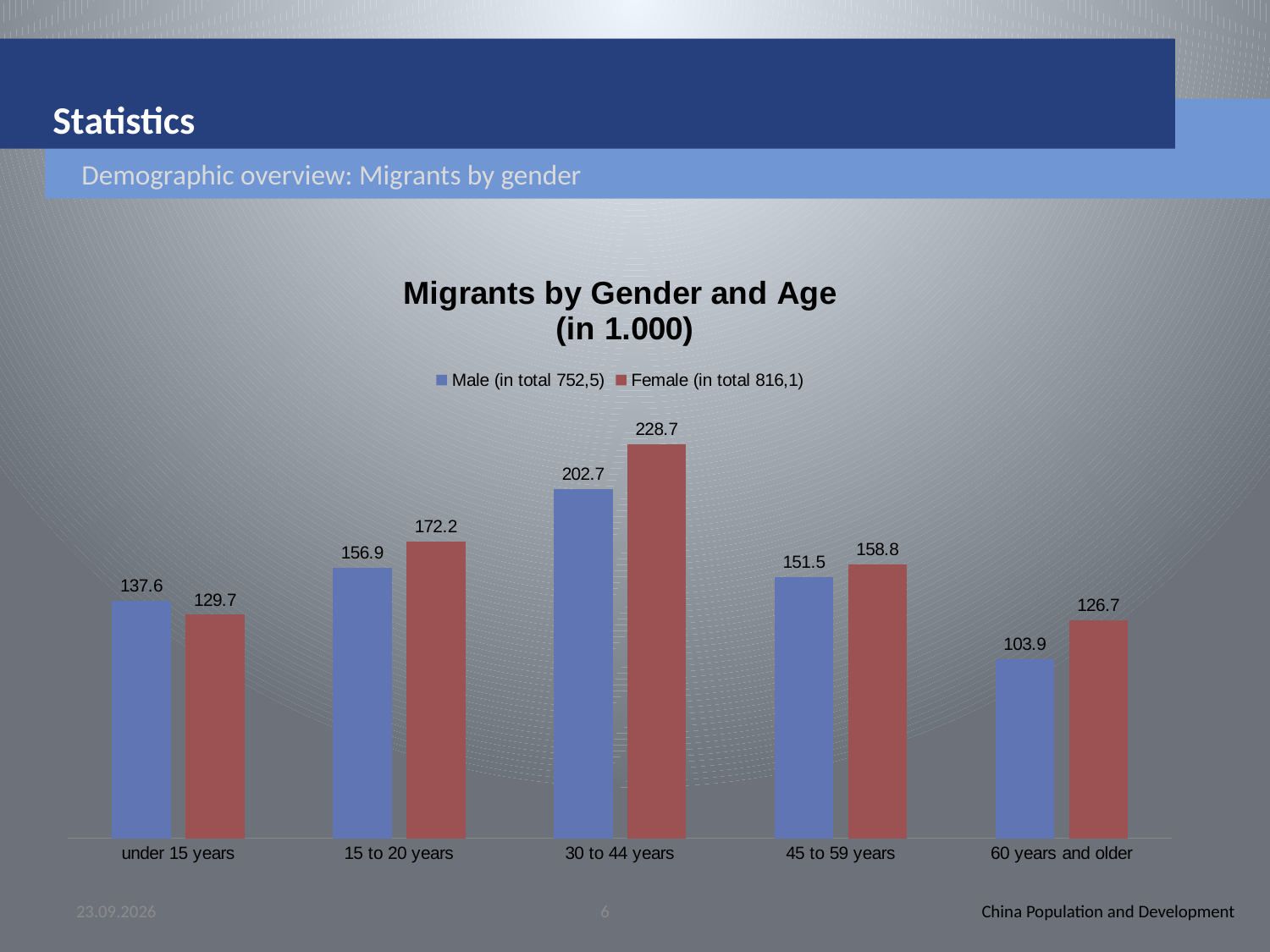
Which age group has the lowest Male value? 60 years and older What is the difference between the Female and Male values for 30 to 44 years? 26 Which age group has the highest Female value? 30 to 44 years What is the Female value for the 60 years and older age group? 126.7 For the under 15 years group, which is larger, the Male or the Female value? Male What kind of chart is shown on the slide? Bar chart What is the difference between the Male and Female values for under 15 years? 7.9 How many age groups are shown on the x axis? 5 For the 15 to 20 years group, which is larger, the Male or the Female value? Female What is the Male value for under 15 years? 137.6 How many series does the legend list? 2 What is the Male value for the 30 to 44 years age group? 202.7